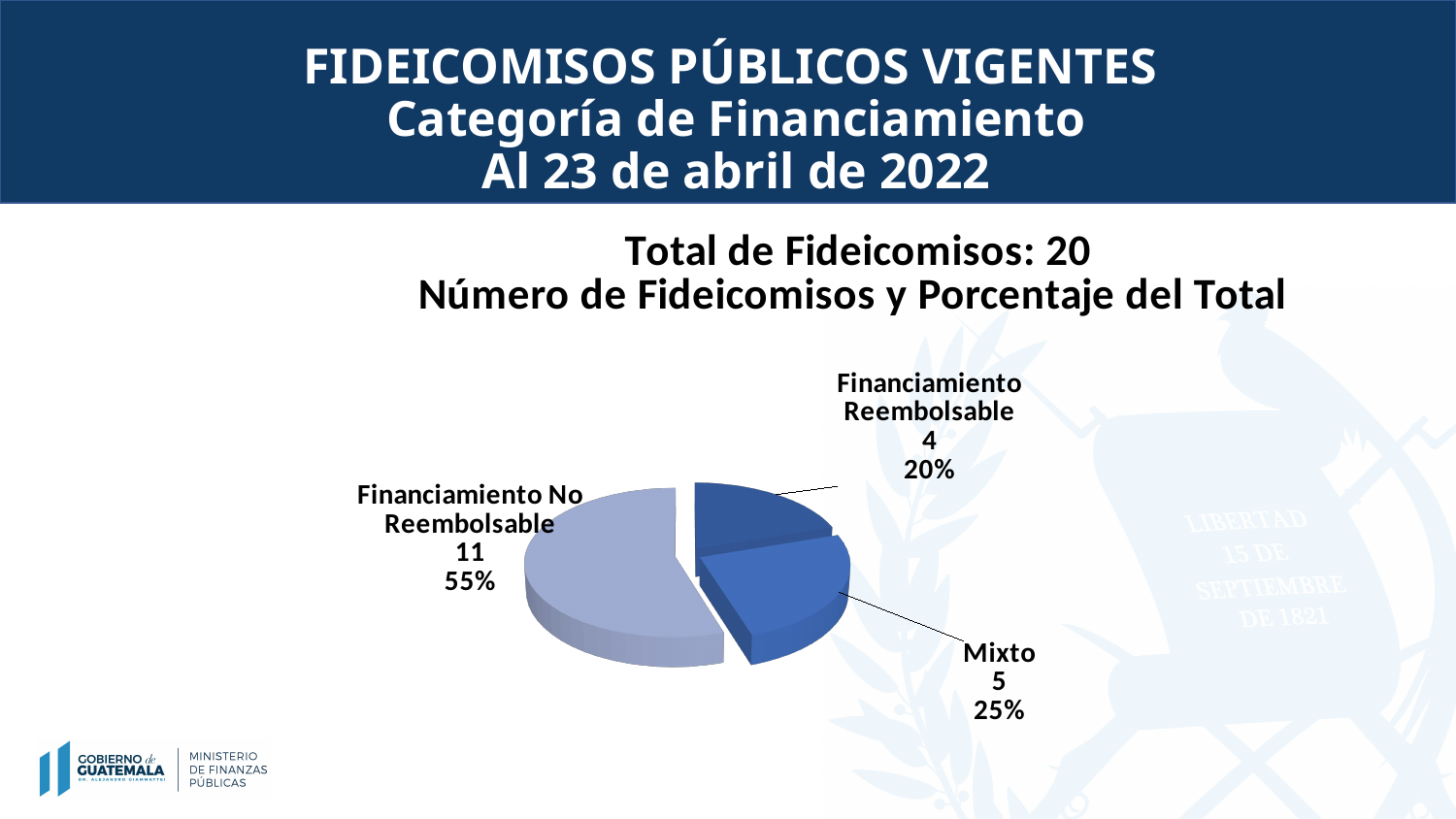
What percentage of the total does Financiamiento No Reembolsable represent? 55% How many fideicomisos are in the Mixto category? 5 How many fideicomisos are in the Financiamiento No Reembolsable category? 11 What is the total number of fideicomisos stated on the slide? 20 What kind of chart is shown on the slide? Pie chart What percentage of the total does the Mixto slice represent? 25% What is the difference in the number of fideicomisos between Financiamiento No Reembolsable and Mixto? 6 Which category has the smallest number of fideicomisos? Financiamiento Reembolsable Which category has the largest number of fideicomisos? Financiamiento No Reembolsable How many categories are shown in the pie chart? 3 Which has more fideicomisos, Mixto or Financiamiento Reembolsable? Mixto What percentage of the total does Financiamiento Reembolsable represent? 20%